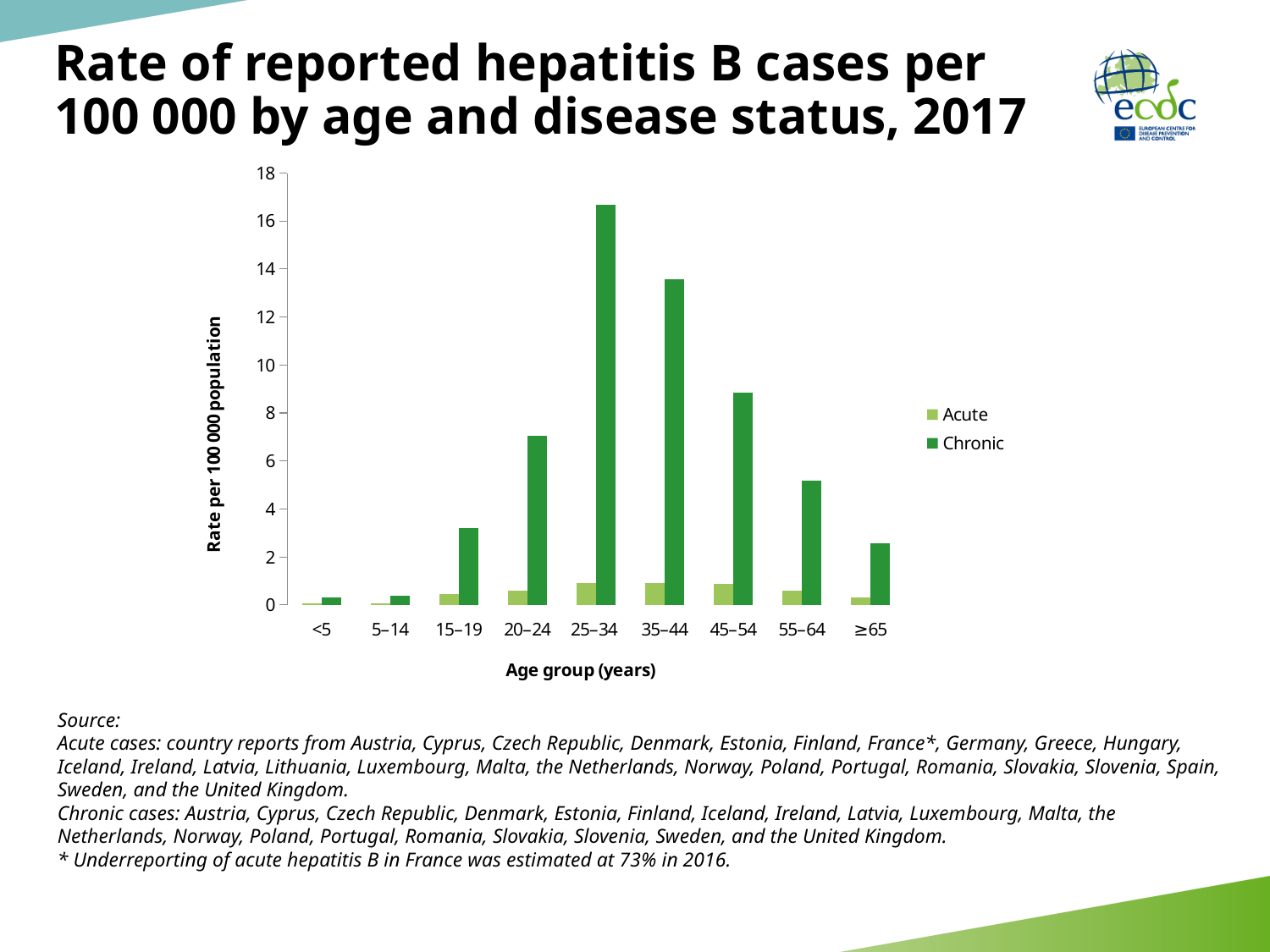
Does the Chronic rate rise or fall from the 25–34 age group to the ≥65 age group? fall What type of chart is shown on the slide? Bar chart What is the title of the y axis? Rate per 100 000 population Is the Acute value for the 25–34 age group greater or less than 2? less How many series does the legend list? 2 Which is larger, the Chronic rate for 35–44 or for 45–54? 35–44 Is the Chronic value for the 55–64 age group greater or less than 4? greater How many age groups are shown on the x axis? 9 Which age group has the highest Chronic rate? 25–34 Is the Chronic value for the 35–44 age group greater or less than 12? greater